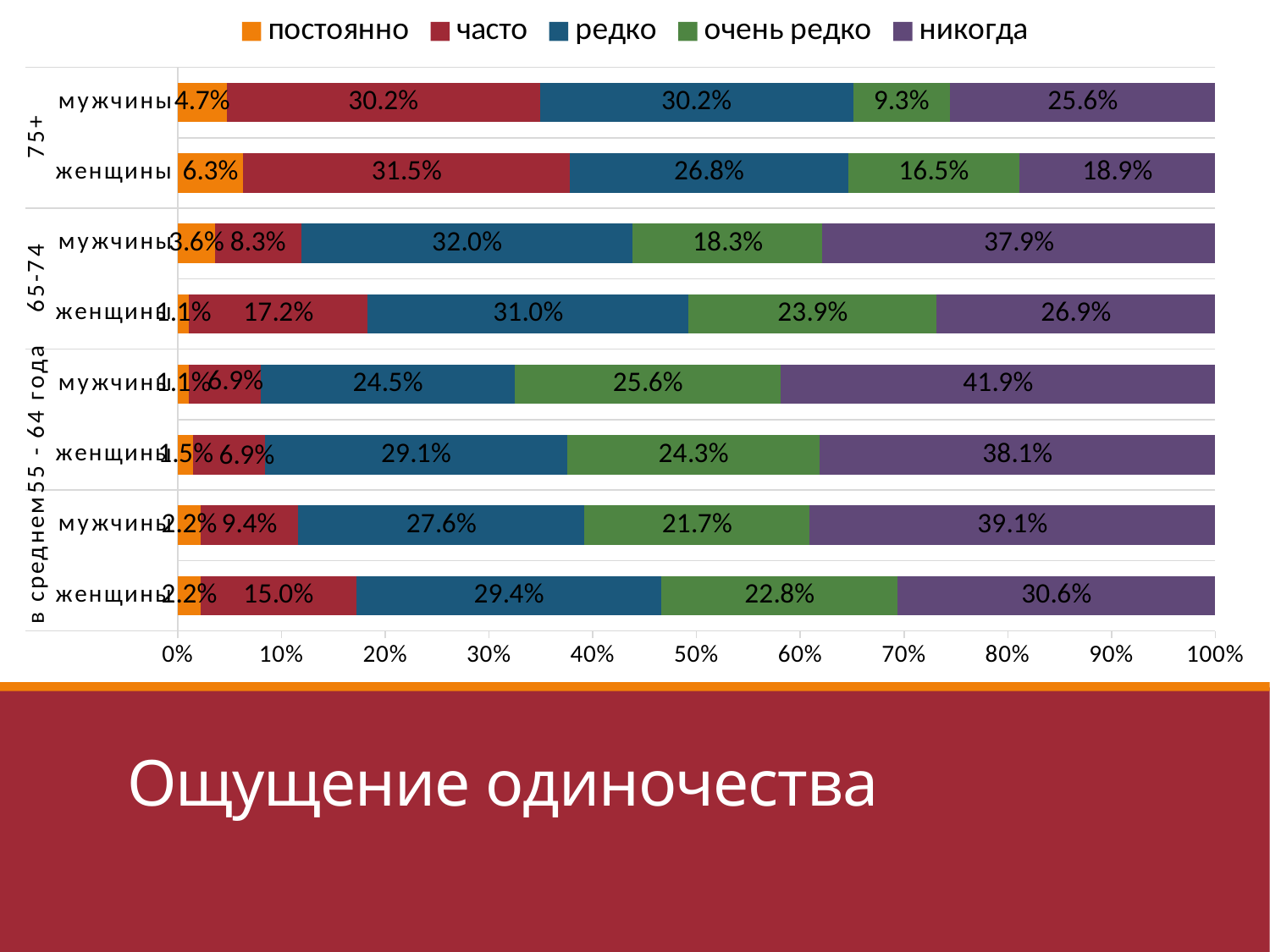
How many bars are plotted in the chart? 8 Which is larger: the 'очень редко' value for женщины in the 75+ group or for мужчины in the 75+ group? женщины, 75+ What is the value of 'часто' for женщины in the 75+ group? 31.5% Which bar has the lowest value for 'никогда'? женщины, 75+ What is the difference between the 'часто' values for женщины and мужчины in the 65-74 group? 8.9% What is the value of 'никогда' for мужчины in the 55 - 64 года group? 41.9% Which bar has the highest value for 'никогда'? мужчины, 55 - 64 года How many series does the legend list? 5 What is the value of 'очень редко' for мужчины in the 75+ group? 9.3% What is the value of 'редко' for женщины in the 65-74 group? 31.0% Which series is shown in orange in the legend? постоянно What kind of chart is shown on the slide? stacked bar chart